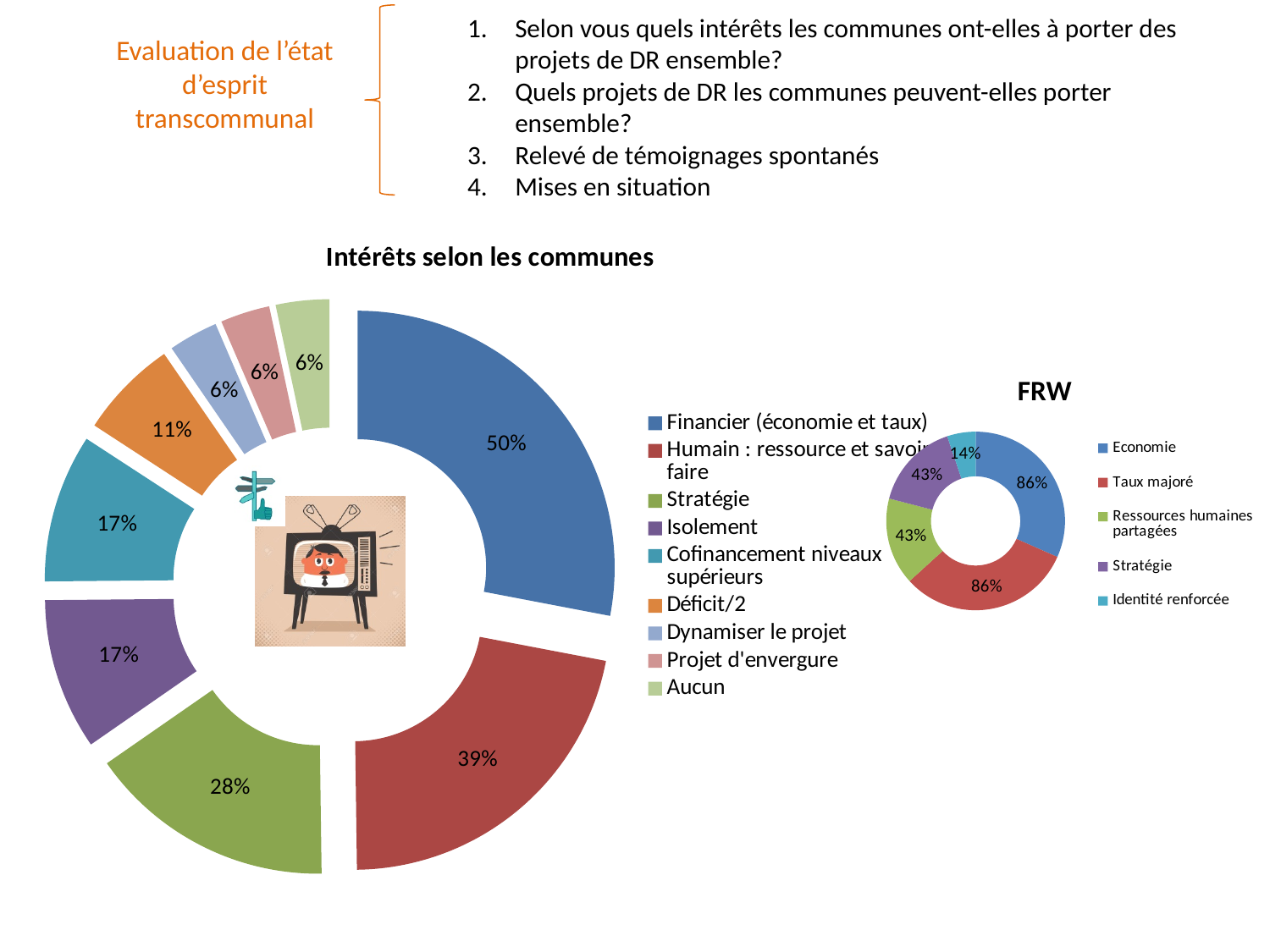
In the 'Intérêts selon les communes' chart, what is the value for Stratégie? 28% In the 'Intérêts selon les communes' chart, what is the value for Déficit/2? 11% How many categories does the legend of the 'Intérêts selon les communes' chart list? 9 What kind of chart is 'Intérêts selon les communes'? doughnut chart In the 'Intérêts selon les communes' chart, what is the value for Financier (économie et taux)? 50% In the 'FRW' chart, what is the value for Identité renforcée? 14% In the 'Intérêts selon les communes' chart, which category has the highest value? Financier (économie et taux) In the 'Intérêts selon les communes' chart, what is the difference between the values for Financier (économie et taux) and Humain : ressource et savoir faire? 11% How many categories does the legend of the 'FRW' chart list? 5 In the 'Intérêts selon les communes' chart, which is larger, Stratégie or Isolement? Stratégie In the 'FRW' chart, which category has the lowest value? Identité renforcée In the 'FRW' chart, what is the value for Economie? 86%